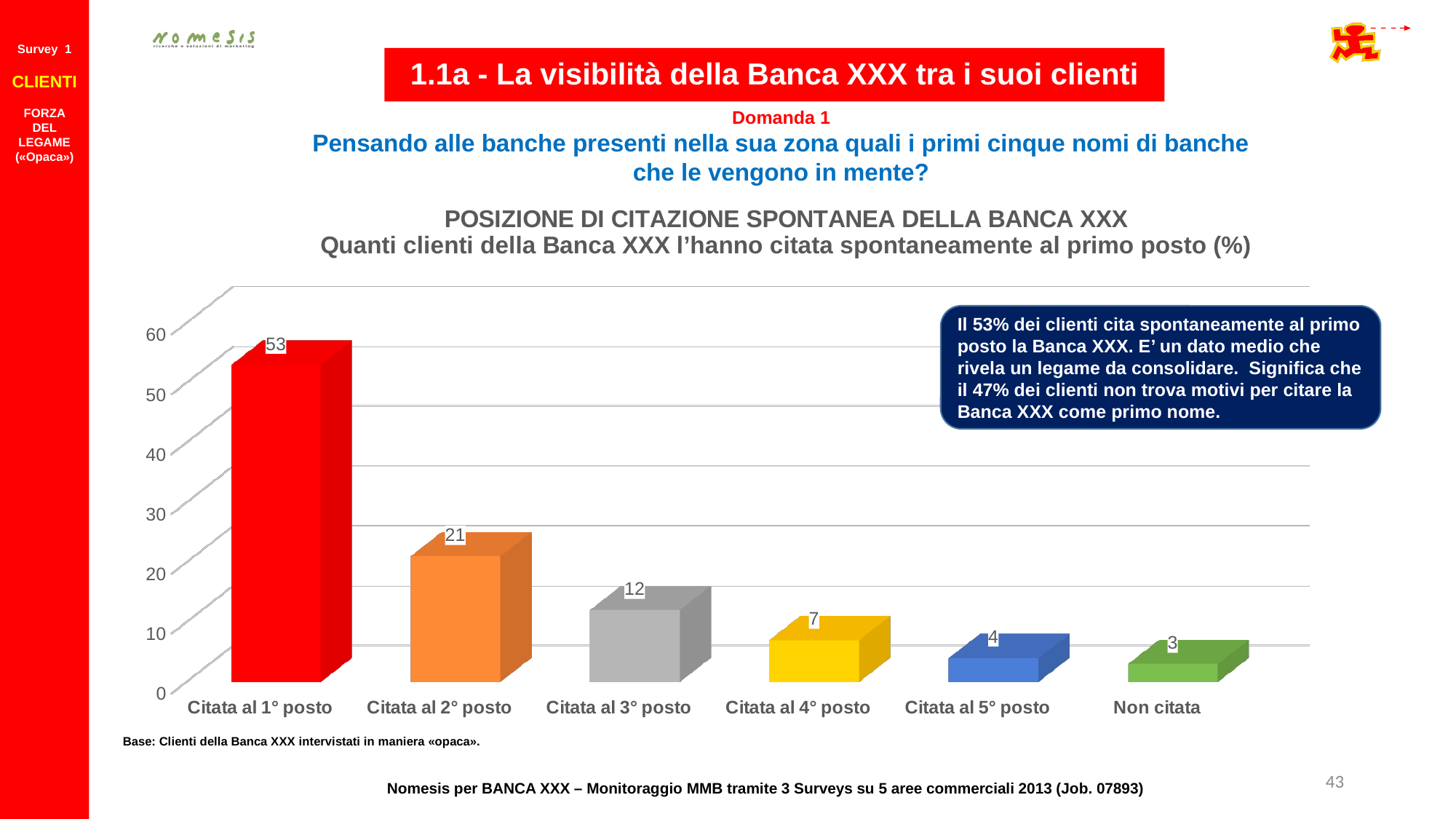
What value is shown for "Citata al 1° posto"? 53 Which category has the highest value? Citata al 1° posto What colour is the bar for "Citata al 1° posto"? red What value is shown for "Citata al 3° posto"? 12 Is the value for "Citata al 2° posto" greater or less than 30? less Which is larger, the value for "Citata al 4° posto" or "Citata al 5° posto"? Citata al 4° posto Do the values rise or fall from left to right along the x axis? fall What kind of chart is shown on the slide? bar chart Which category has the lowest value? Non citata How many categories are shown on the x axis? 6 What value is shown for "Non citata"? 3 What is the difference between the values for "Citata al 1° posto" and "Citata al 2° posto"? 32